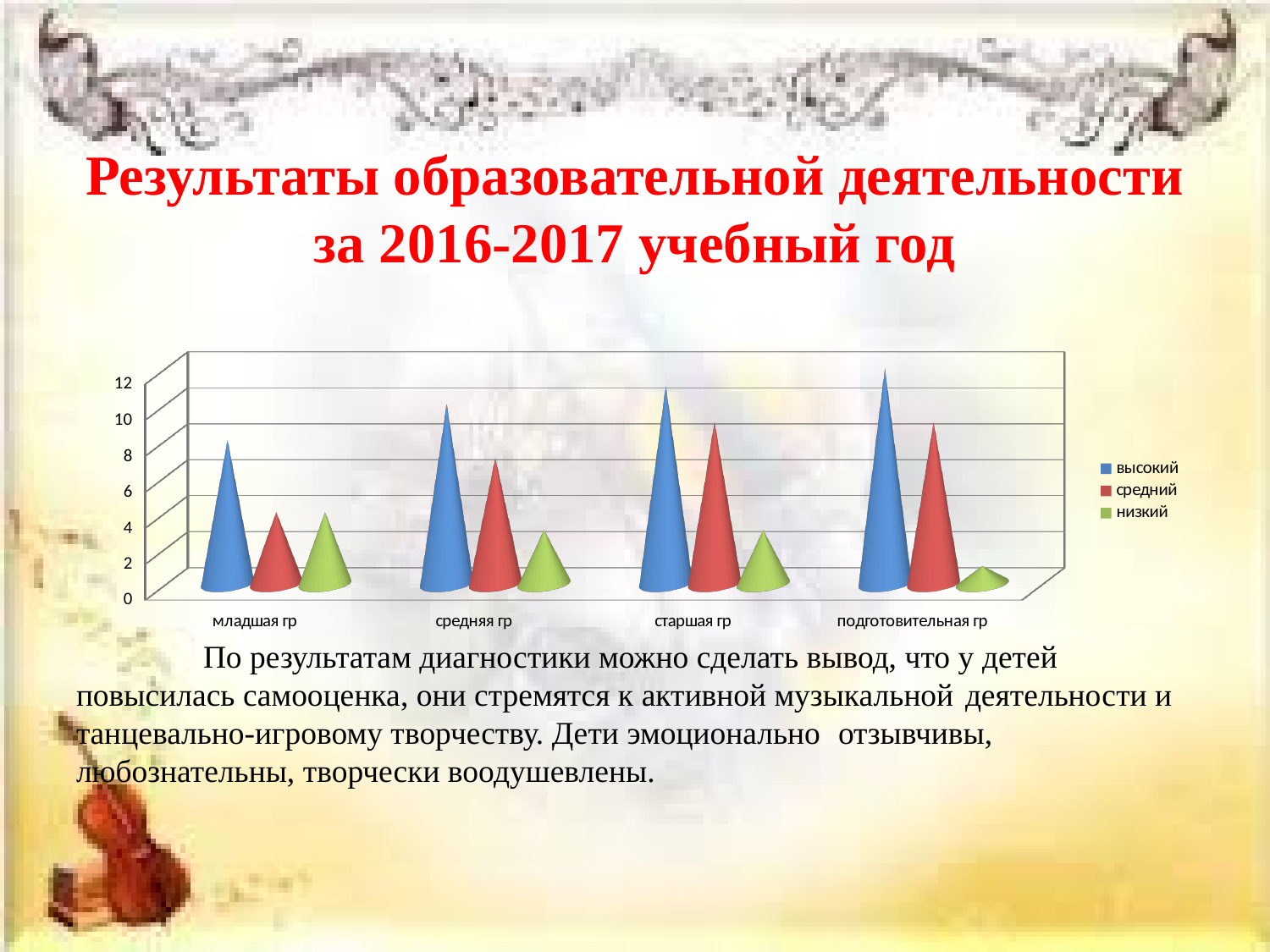
How many series does the chart legend list? 3 What kind of chart is shown on the slide? bar chart Is the value for 'низкий' in 'подготовительная гр' greater or less than 2? less Which category has the highest value for the series 'высокий'? подготовительная гр Which category has the lowest value for the series 'низкий'? подготовительная гр Is the value for 'средний' in 'старшая гр' greater or less than 6? greater Does the value for 'высокий' rise or fall from 'младшая гр' to 'подготовительная гр'? rise Is the value for 'высокий' in 'подготовительная гр' greater or less than 10? greater In 'младшая гр', which is larger: the value for 'высокий' or the value for 'средний'? высокий Which colour represents the series 'высокий' in the chart legend? blue How many categories (groups) are shown on the x axis of the chart? 4